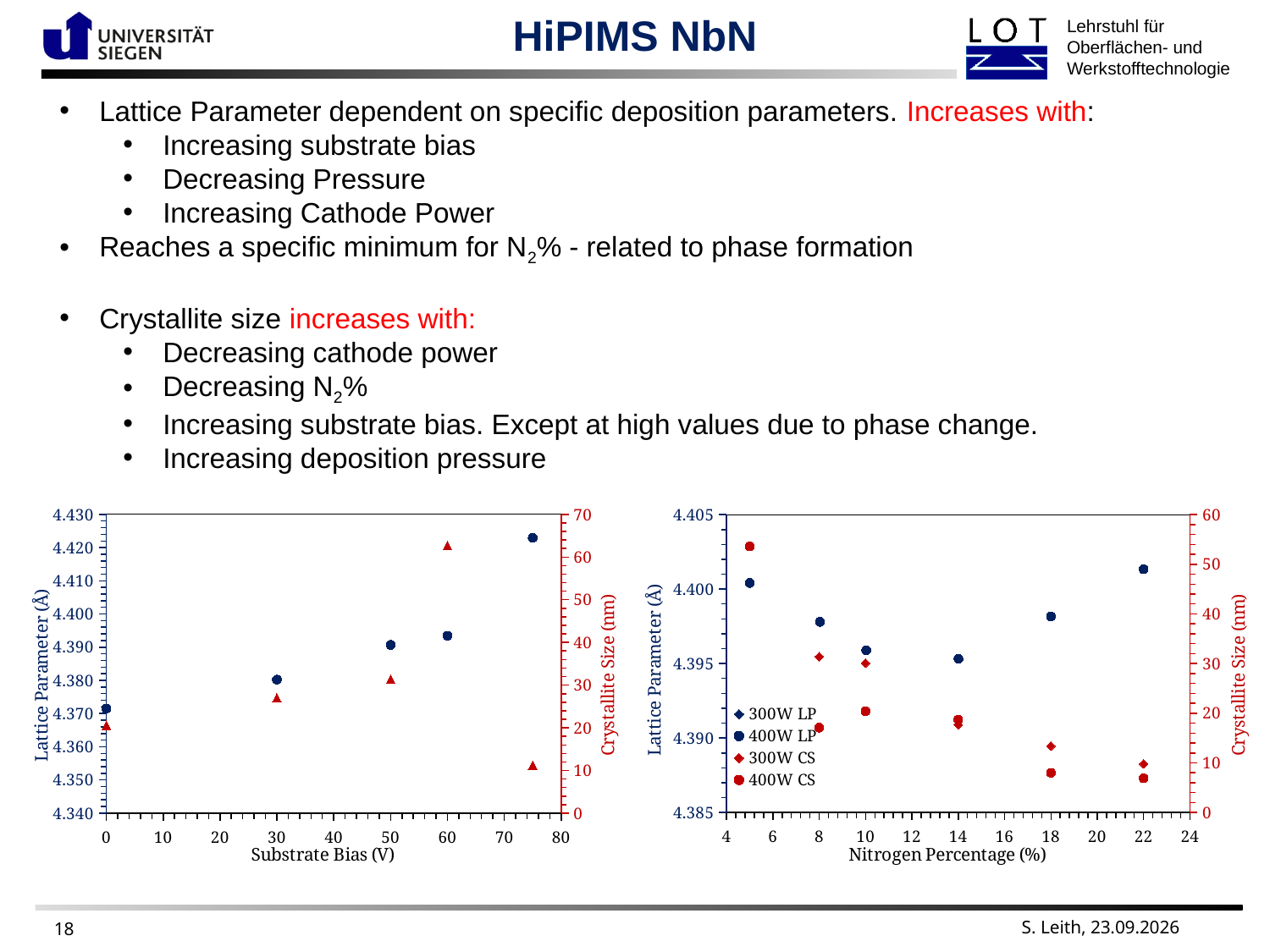
In the left chart (Substrate Bias), at which substrate bias is the crystallite size highest? 60 V In the left chart (Substrate Bias), at which substrate bias is the crystallite size lowest? 75 V How many series does the legend of the right chart (Nitrogen Percentage) list? 4 In the left chart (Substrate Bias), is the crystallite size at 60 V greater or less than 50 nm? greater In the right chart (Nitrogen Percentage), is the 400W CS crystallite size at 5% greater or less than 40 nm? greater In the left chart (Substrate Bias), at which substrate bias is the lattice parameter highest? 75 V In the left chart (Substrate Bias), how many blue circle data points (Lattice Parameter) are plotted? 5 In the left chart (Substrate Bias), is the lattice parameter at 75 V greater or less than 4.410? greater What is the x-axis label of the right chart? Nitrogen Percentage (%) In the left chart (Substrate Bias), does the lattice parameter rise or fall as substrate bias increases? rise What kind of chart is the left chart (Substrate Bias)? scatter chart